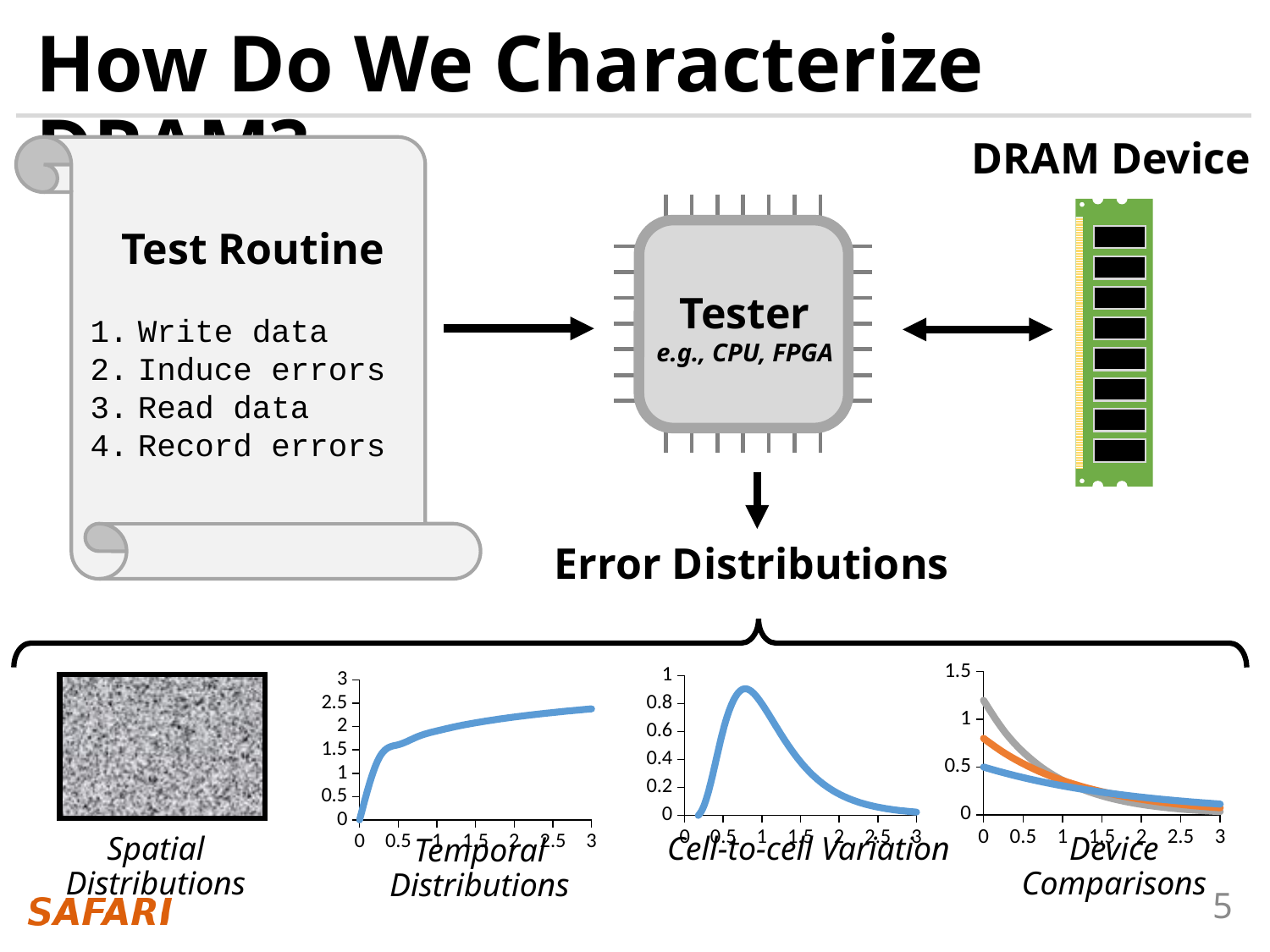
In the 'Device Comparisons' chart, is the gray line's value at x = 0 greater or less than 1? greater How many lines are plotted in the 'Device Comparisons' chart? 3 In the 'Temporal Distributions' chart, what is the highest value shown on the y axis? 3 In the 'Cell-to-cell Variation' chart, is the peak of the curve located at an x value greater or less than 1.5? less In the 'Temporal Distributions' chart, is the value at x = 3 greater or less than 2? greater What kind of chart is the 'Temporal Distributions' chart? line chart In the 'Device Comparisons' chart, what is the highest value shown on the y axis? 1.5 In the 'Device Comparisons' chart, which coloured line has the highest value at x = 0? gray In the 'Device Comparisons' chart, do the lines rise or fall as x increases? fall In the 'Temporal Distributions' chart, do the values rise or fall as x increases from 0 to 3? rise